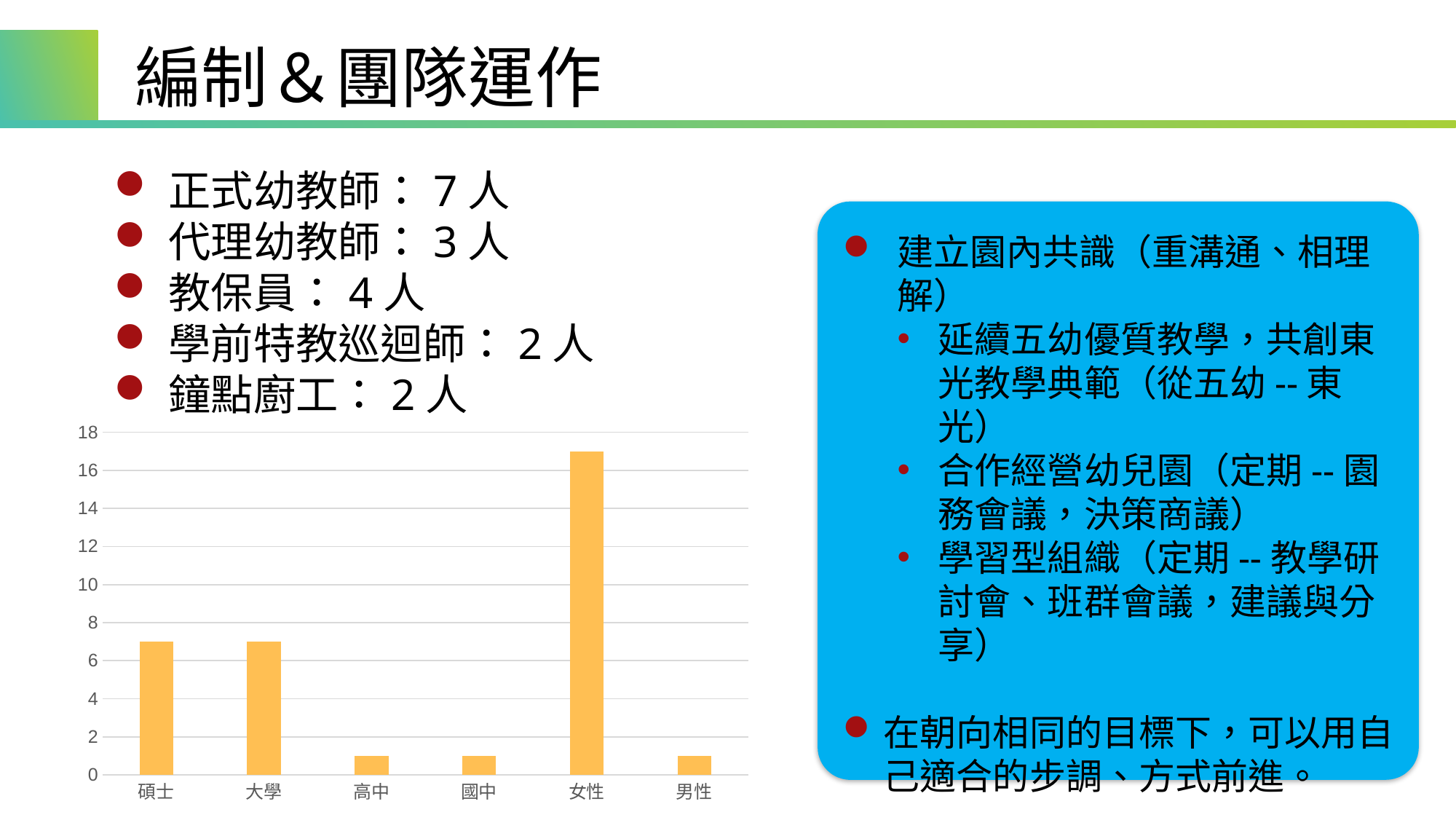
Which category has the highest bar in the chart? 女性 Is the value for 高中 greater or less than 2? less What colour are the bars in the chart? orange How many categories are shown on the x axis of the chart? 6 Which is larger, the value for 碩士 or the value for 國中? 碩士 What is the highest value shown on the chart's vertical axis? 18 Which is larger, the value for 女性 or the value for 男性? 女性 Is the value for 男性 greater or less than 4? less Is the value for 碩士 greater or less than 4? greater What kind of chart is shown on the slide? bar chart